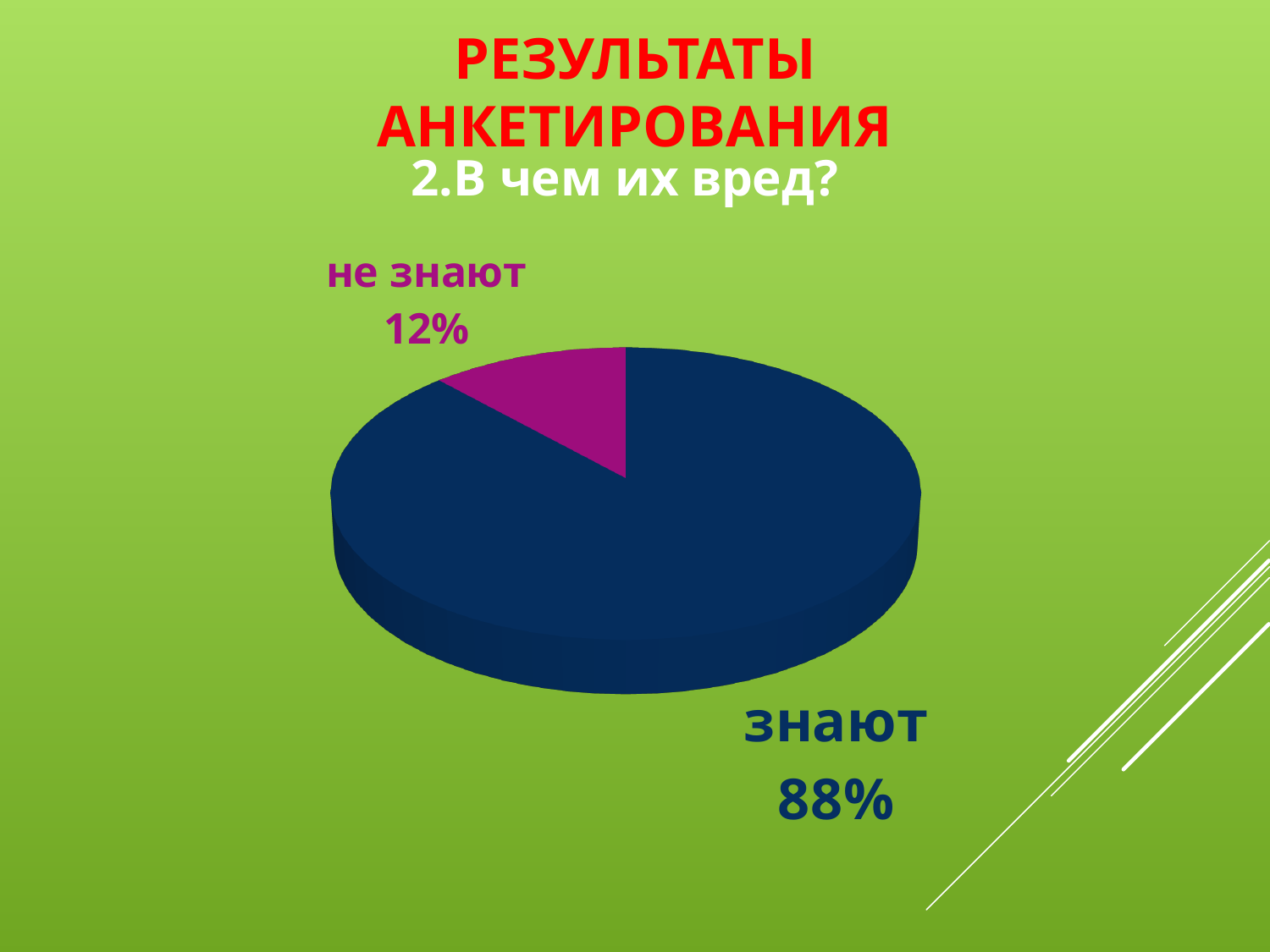
Which is larger: the "знают" slice or the "не знают" slice? знают What kind of chart is shown on the slide? pie chart What colour is the "не знают" slice? purple What share of the pie does the "знают" slice represent? 88% What is the difference between the "знают" and "не знают" shares? 76% What is the total of the two slices shown in the pie chart? 100% Which slice is the largest in the pie chart? знают How many slices does the pie chart have? 2 What question does the chart's subtitle pose? 2.В чем их вред? Which slice is the smallest in the pie chart? не знают What share of the pie does the "не знают" slice represent? 12%